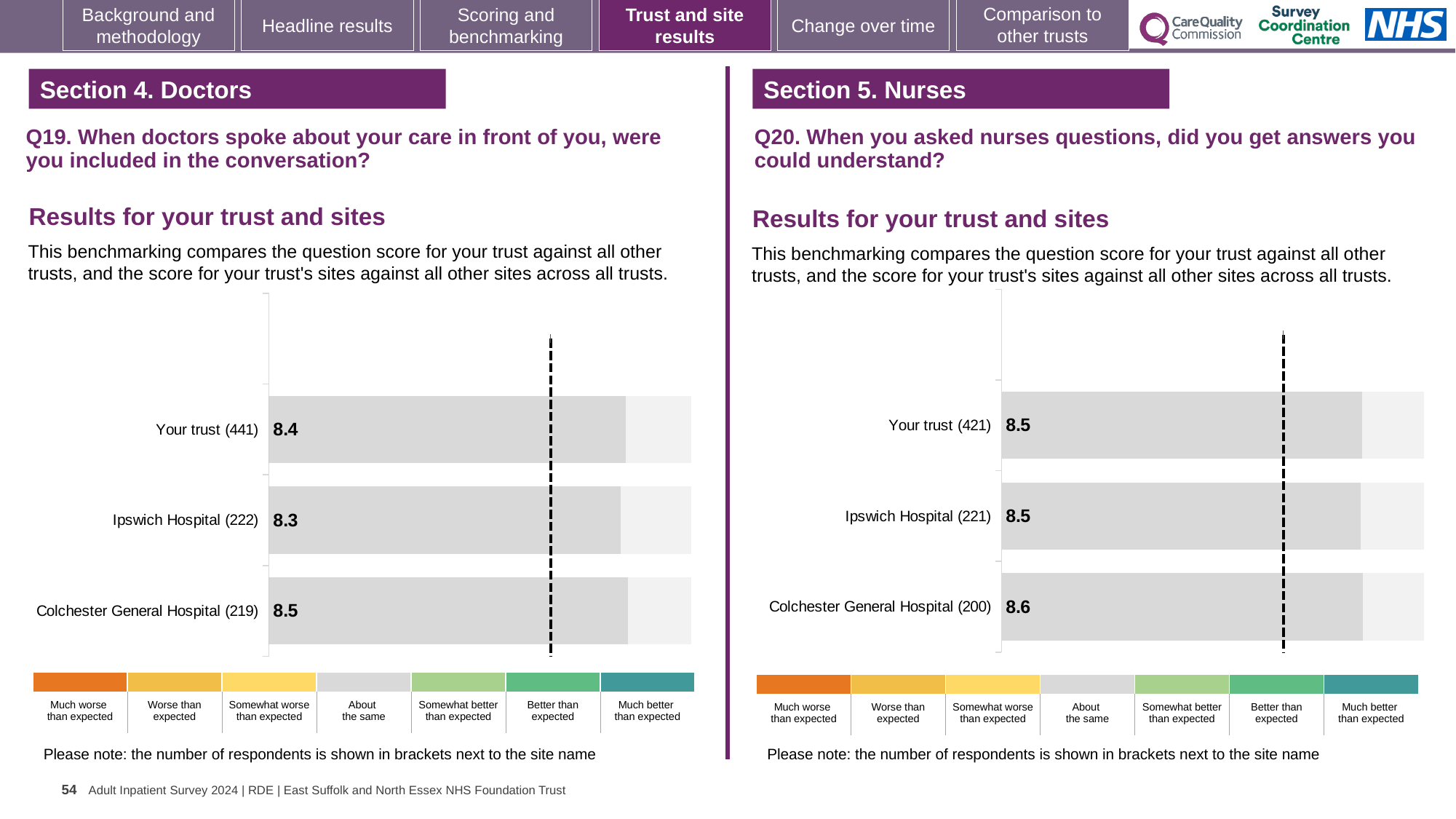
In the Q19 chart on the left, which site or trust has the lowest score? Ipswich Hospital In the Q19 chart on the left, what is the score for Your trust? 8.4 In the Q19 chart on the left, what is the difference between the scores for Colchester General Hospital and Ipswich Hospital? 0.2 In the Q19 chart on the left, what is the score for Ipswich Hospital? 8.3 In the Q20 chart on the right, what is the score for Your trust? 8.5 How many bars are plotted in the Q20 chart on the right? 3 In the Q20 chart on the right, how many respondents are shown for Colchester General Hospital? 200 In the Q20 chart on the right, which site or trust has the highest score? Colchester General Hospital In the Q19 chart on the left, which site or trust has the highest score? Colchester General Hospital In the Q20 chart on the right, what is the score for Colchester General Hospital? 8.6 In the Q19 chart on the left, how many respondents are shown for Your trust? 441 What kind of chart is the Q19 chart on the left? Bar chart